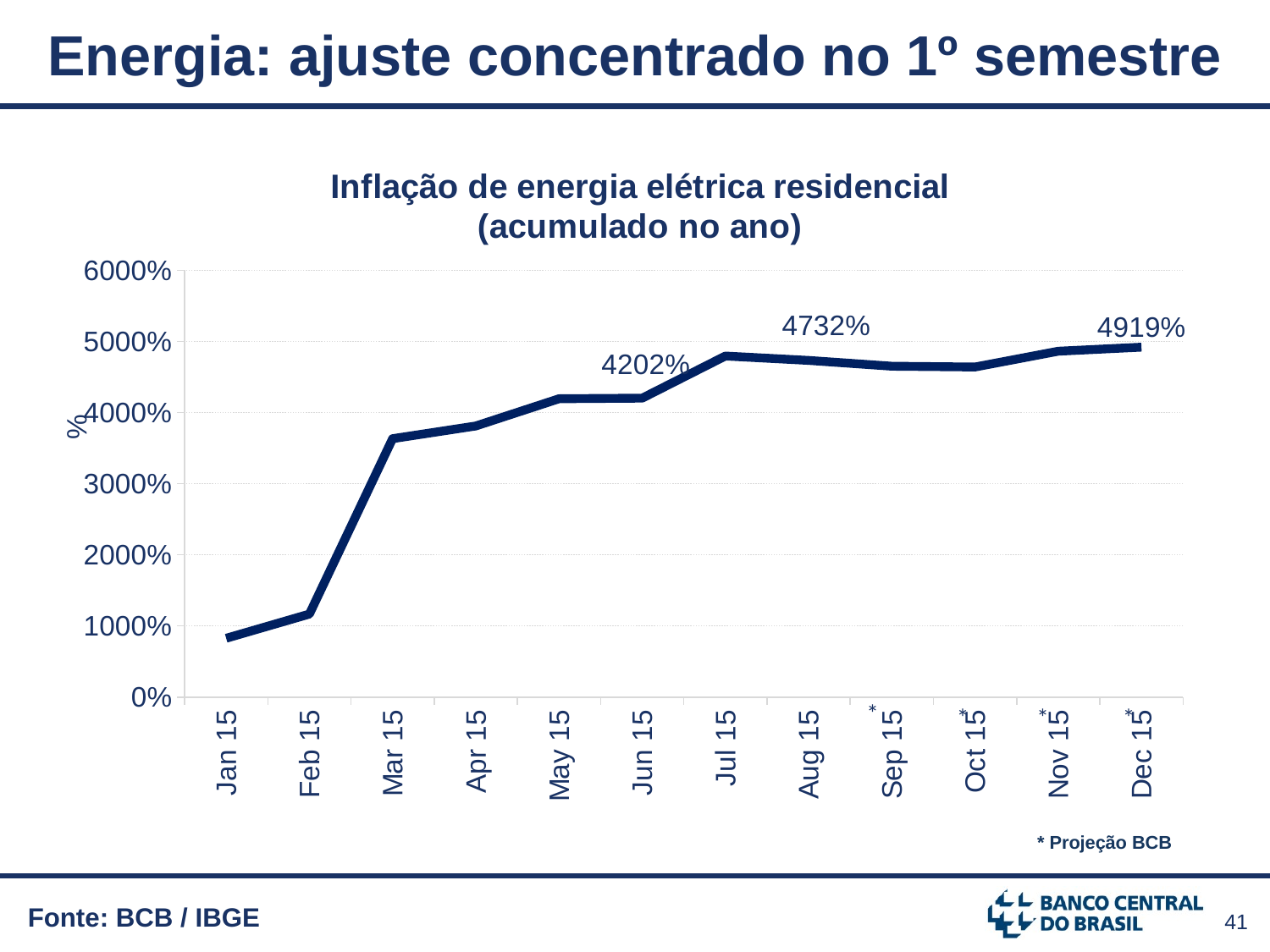
What is the difference between the values for Dec 15 and Jun 15? 717% What is the value for Dec 15? 4919% Is the value for Jan 15 greater or less than 1000%? less Which is larger, the value for Mar 15 or the value for Feb 15? Mar 15 How many months are plotted along the x axis? 12 Which month has the lowest value? Jan 15 Is the value for Mar 15 greater or less than 3000%? greater What is the value for Jun 15? 4202% What is the value for Aug 15? 4732% What is the difference between the values for Dec 15 and Aug 15? 187% Do the values rise or fall from Jan 15 to Jul 15? rise What kind of chart is shown on the slide? line chart